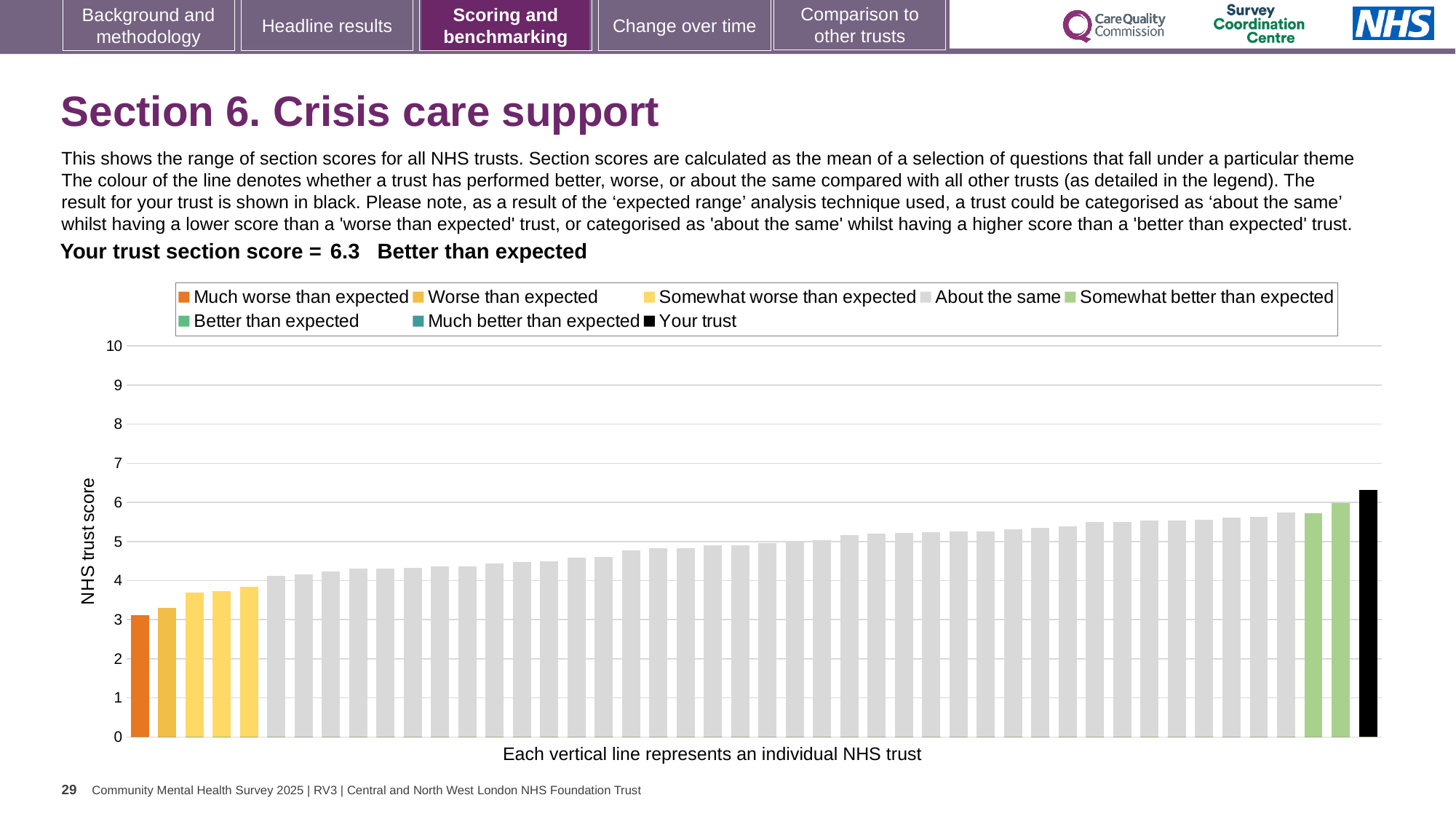
What kind of chart is shown on the slide? bar chart How many bars are coloured as 'Much worse than expected'? 1 What is the label on the vertical axis of the chart? NHS trust score What colour is the bar representing your trust? black Do the bar values rise or fall from left to right along the x axis? rise Is the value for your trust greater or less than 6? greater What is the section score for your trust shown on the slide? 6.3 How many bars are coloured as 'Somewhat better than expected'? 2 Is the value of the lowest bar (Much worse than expected) greater or less than 4? less Which performance category is your trust placed in according to the slide? Better than expected Which bar has the highest NHS trust score in the chart? Your trust How many entries does the chart legend list? 8